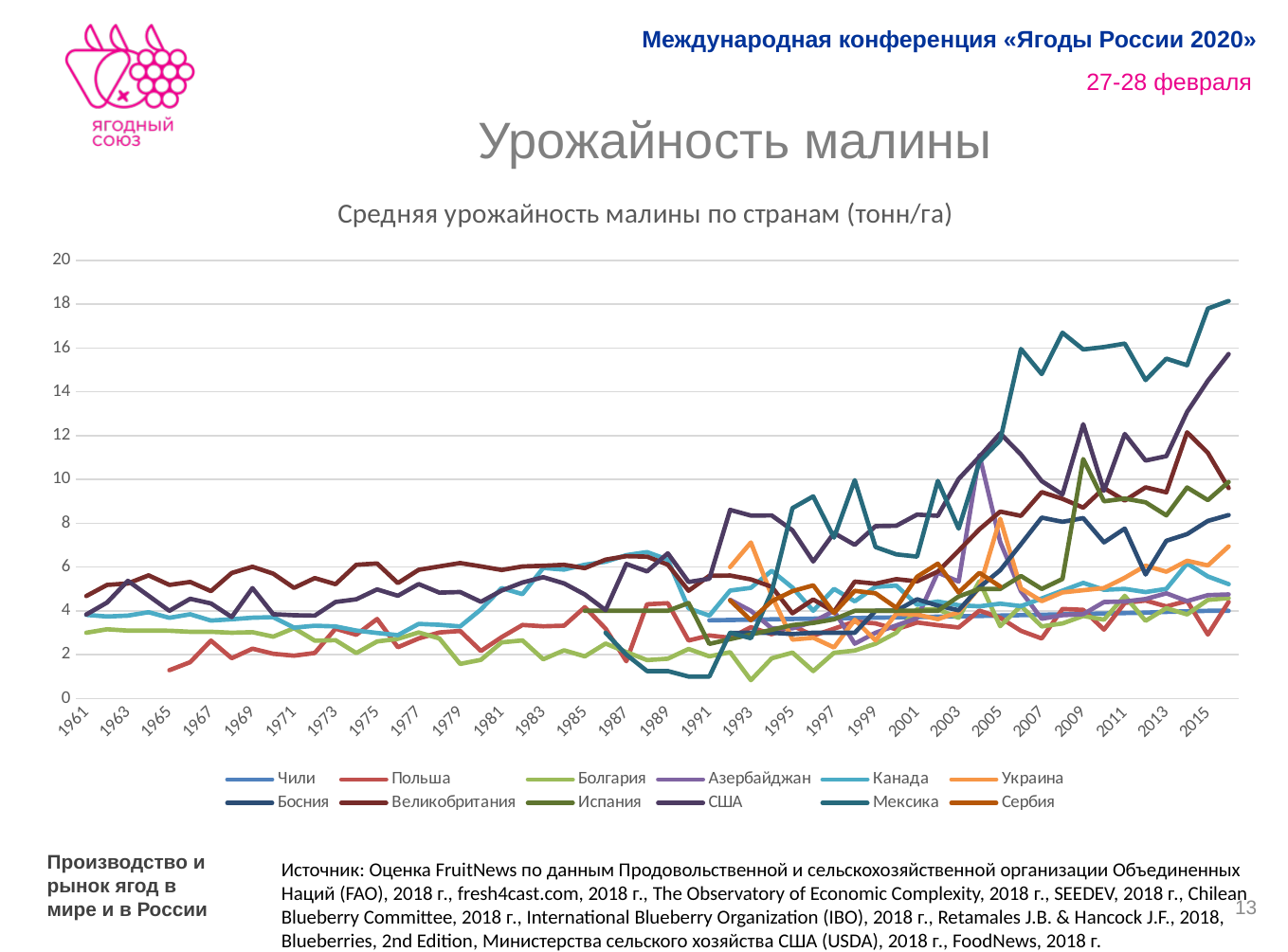
Is the value for Польша in 1965 greater or less than 2? less How many series does the legend list? 12 Which is larger in 2015, the value for Мексика or the value for Польша? Мексика Is the value for Мексика in 1991 greater or less than 2? less Is the value for Испания in 2009 greater or less than 10? greater Does the yield for Мексика rise or fall between 1991 and 2016? rise Which country has the highest raspberry yield at the end of the series (2016)? Мексика What is the title of the chart? Средняя урожайность малины по странам (тонн/га) What kind of chart is shown on the slide? line chart What is the highest value shown on the vertical axis? 20